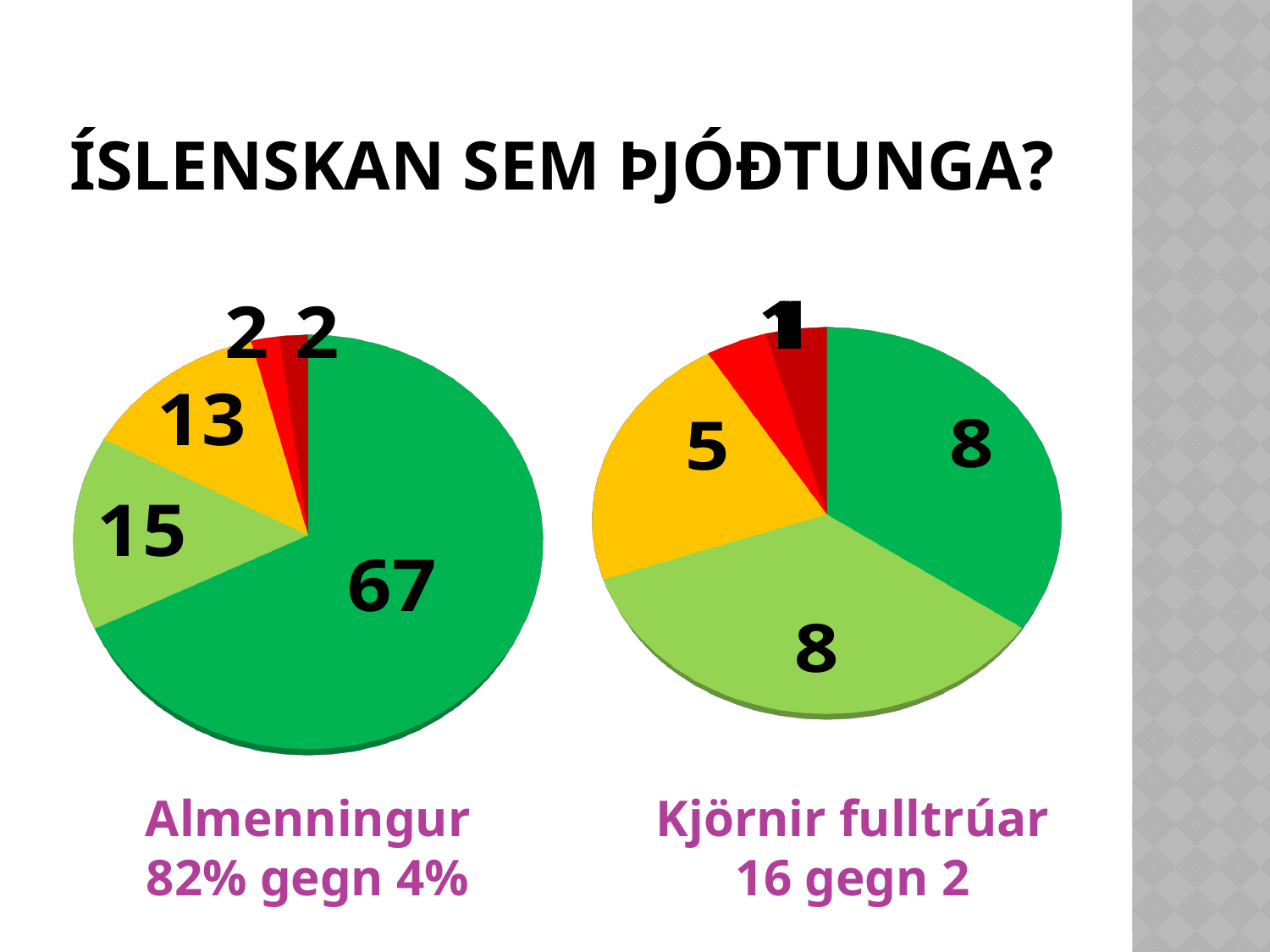
In the Kjörnir fulltrúar pie chart, what value is shown for the yellow slice? 5 In the Almenningur pie chart, what value is shown for the largest dark green slice? 67 In the Kjörnir fulltrúar pie chart, what value is shown for the light green slice? 8 In the Almenningur pie chart, what value is shown for the light green slice? 15 In the Almenningur pie chart, what value is shown for the yellow slice? 13 In the Almenningur pie chart, what is the difference between the dark green slice (67) and the light green slice (15)? 52 What summary text is written under the Kjörnir fulltrúar pie chart? 16 gegn 2 How many slices does the Almenningur pie chart have? 5 In the Almenningur pie chart, which is larger: the light green slice or the yellow slice? The light green slice (15) In the Almenningur pie chart, which slice has the highest value? The dark green slice (67) What kind of charts are shown on the slide? Pie charts In the Kjörnir fulltrúar pie chart, which is larger: the yellow slice or the light green slice? The light green slice (8)